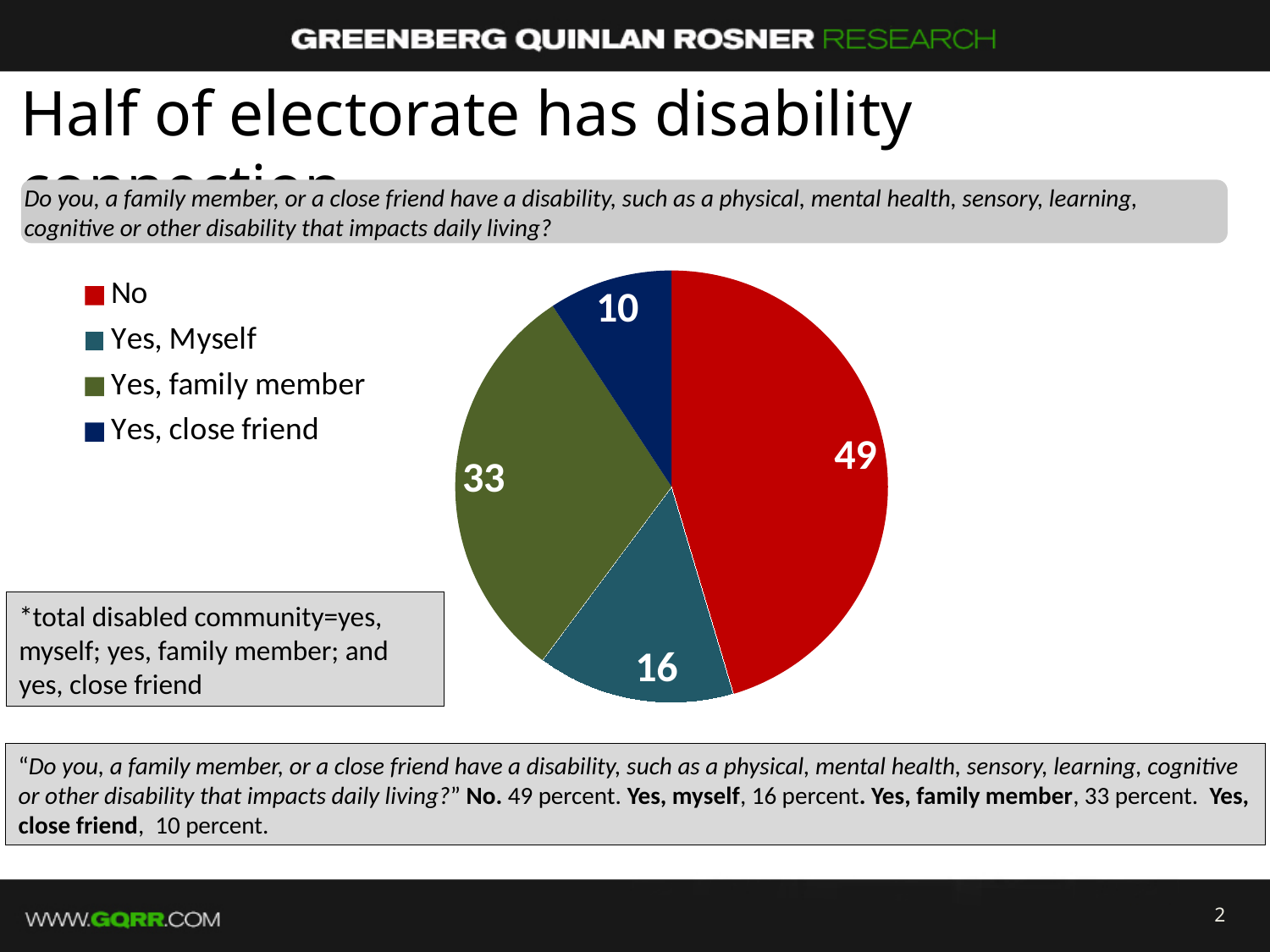
Which is larger, the value for "Yes, Myself" or the value for "Yes, close friend"? Yes, Myself How many categories does the pie chart show? 4 What colour is the "No" slice in the pie chart? red What is the combined value of the three "Yes" categories in the pie chart? 59 What is the value for "Yes, Myself" in the pie chart? 16 What is the difference between the values for "No" and "Yes, family member"? 16 Which category has the smallest slice of the pie chart? Yes, close friend Which category has the largest slice of the pie chart? No What is the value for "Yes, family member" in the pie chart? 33 What is the value for "Yes, close friend" in the pie chart? 10 What kind of chart is shown on the slide? pie chart What is the value for "No" in the pie chart? 49